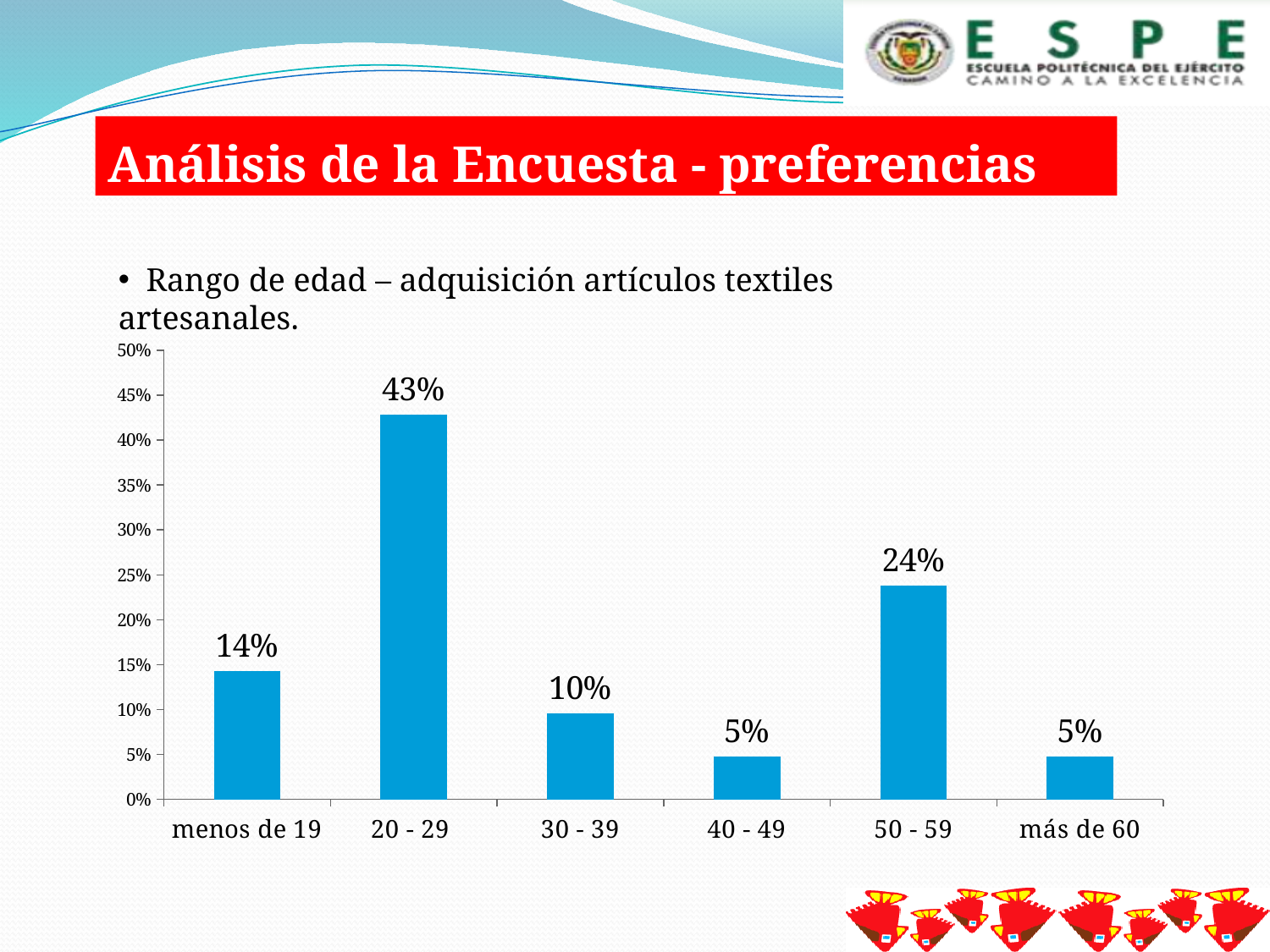
What is the difference between the values for menos de 19 and 30 - 39? 4% What is the value for the 20 - 29 age range? 43% What kind of chart is shown on the slide? bar chart Which is larger, the value for 50 - 59 or the value for menos de 19? 50 - 59 What is the value for the 50 - 59 age range? 24% Which age range has the highest value? 20 - 29 What is the difference between the values for 20 - 29 and 50 - 59? 19% Is the value for 20 - 29 greater or less than 40%? greater How many age range categories are shown on the x axis? 6 What is the value for the 30 - 39 age range? 10% What is the highest value shown on the y axis? 50% What is the value for the menos de 19 category? 14%